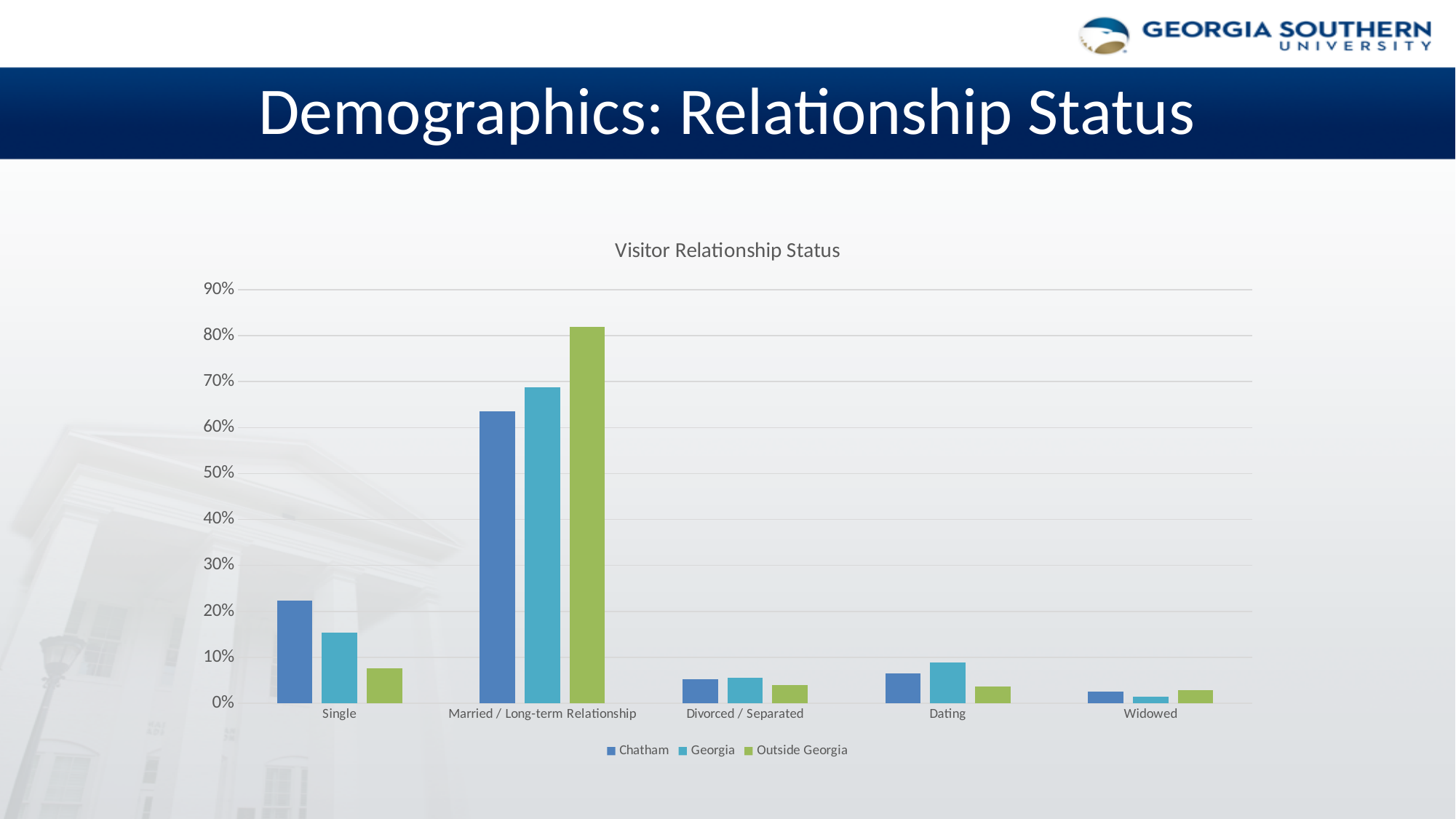
How many relationship status categories are shown on the x axis? 5 Is the value for Outside Georgia in the Married / Long-term Relationship category greater or less than 70%? greater Which series has the highest value in the Married / Long-term Relationship category? Outside Georgia What is the title of the chart? Visitor Relationship Status Which relationship status category has the lowest value for Chatham? Widowed Is the value for Outside Georgia in the Single category greater or less than 10%? less Which relationship status category has the highest value for Outside Georgia? Married / Long-term Relationship How many series does the legend list? 3 Which is larger in the Single category, the value for Chatham or the value for Georgia? Chatham Is the value for Chatham in the Single category greater or less than 20%? greater What kind of chart is shown on the slide? bar chart Which series has the highest value in the Single category? Chatham